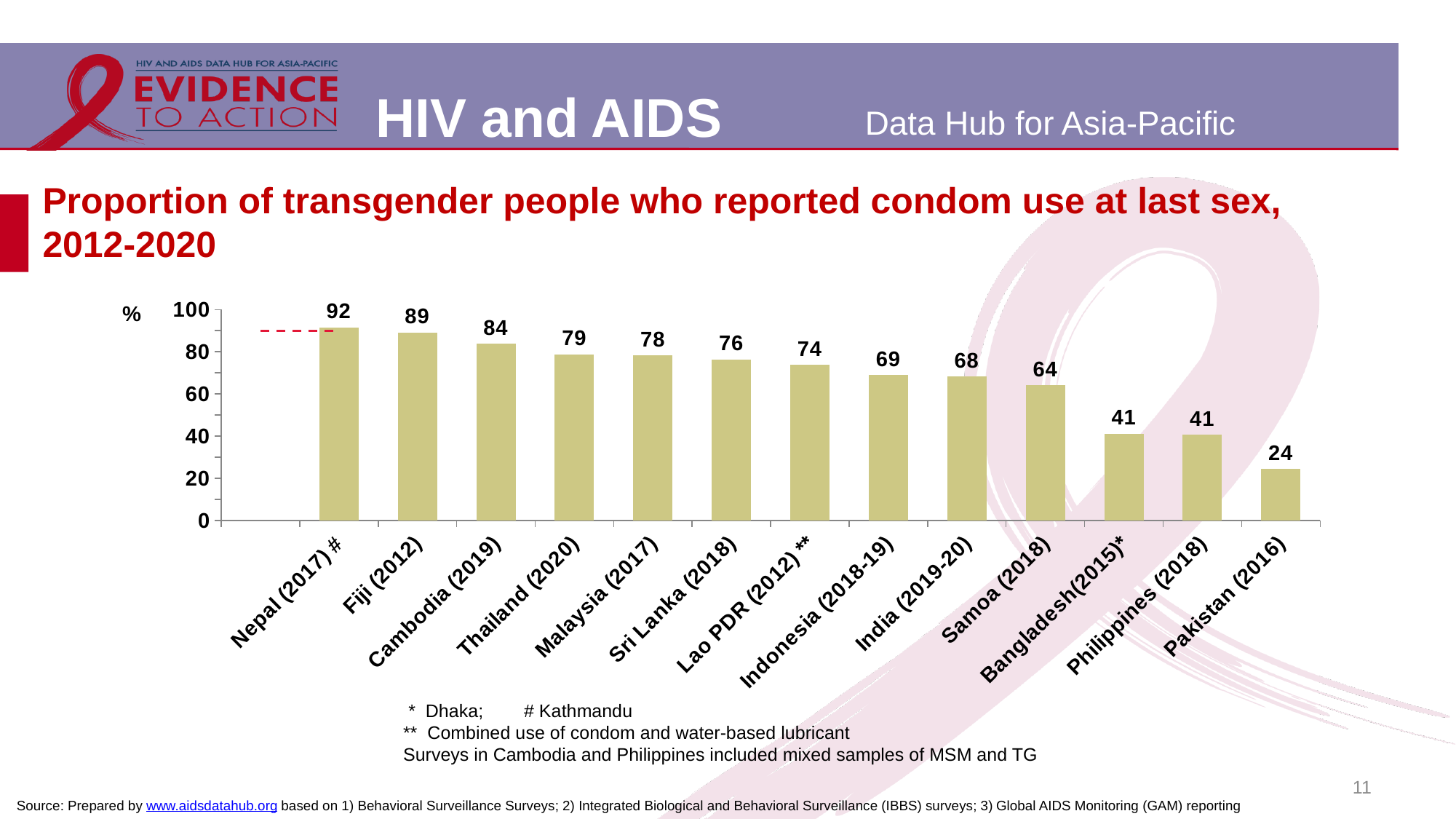
Is the value for India (2019-20) greater or less than 60? greater How many countries are shown in the chart? 13 Which country has the highest proportion of transgender people who reported condom use at last sex? Nepal (2017) What is the value for Pakistan (2016)? 24 Do the values rise or fall from left to right across the chart? Fall What kind of chart is shown on the slide? Bar chart What is the difference between the values for Fiji (2012) and Samoa (2018)? 25 Which country has the lowest proportion of transgender people who reported condom use at last sex? Pakistan (2016) What is the value for Nepal (2017)? 92 Which is larger, the value for Cambodia (2019) or the value for Sri Lanka (2018)? Cambodia (2019) What unit is shown on the y axis of the chart? % What is the value for Thailand (2020)? 79